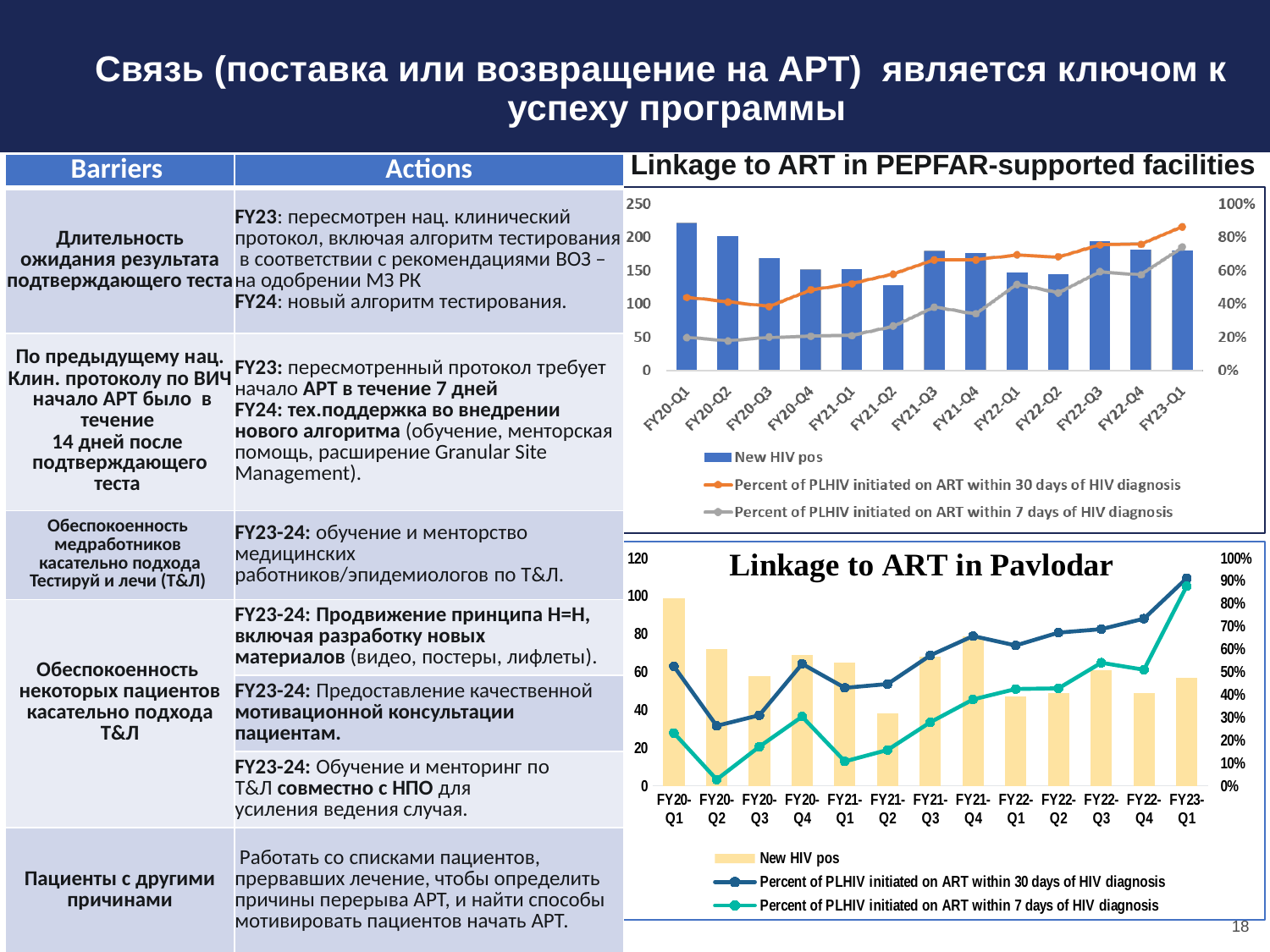
On the 'Linkage to ART in Pavlodar' chart, at FY20-Q1, which is higher: the percent initiated on ART within 30 days or within 7 days? Within 30 days On the 'Linkage to ART in PEPFAR-supported facilities' chart, how many series does the legend list? 3 What kind of chart is 'Linkage to ART in Pavlodar'? Combined bar and line chart On the 'Linkage to ART in PEPFAR-supported facilities' chart, does the percent of PLHIV initiated on ART within 30 days generally rise or fall from FY20-Q1 to FY23-Q1? rise On the 'Linkage to ART in PEPFAR-supported facilities' chart, which quarter has the highest New HIV pos bar? FY20-Q1 On the 'Linkage to ART in PEPFAR-supported facilities' chart, is the percent of PLHIV initiated on ART within 30 days for FY23-Q1 greater or less than 80%? greater On the 'Linkage to ART in PEPFAR-supported facilities' chart, which quarter has the lowest New HIV pos bar? FY21-Q2 On the 'Linkage to ART in Pavlodar' chart, is the percent of PLHIV initiated on ART within 7 days for FY20-Q2 greater or less than 10%? less On the 'Linkage to ART in Pavlodar' chart, is the New HIV pos value for FY21-Q2 greater or less than 60? less On the 'Linkage to ART in PEPFAR-supported facilities' chart, how many quarters are shown on the x axis? 13 On the 'Linkage to ART in Pavlodar' chart, which quarter has the highest New HIV pos bar? FY20-Q1